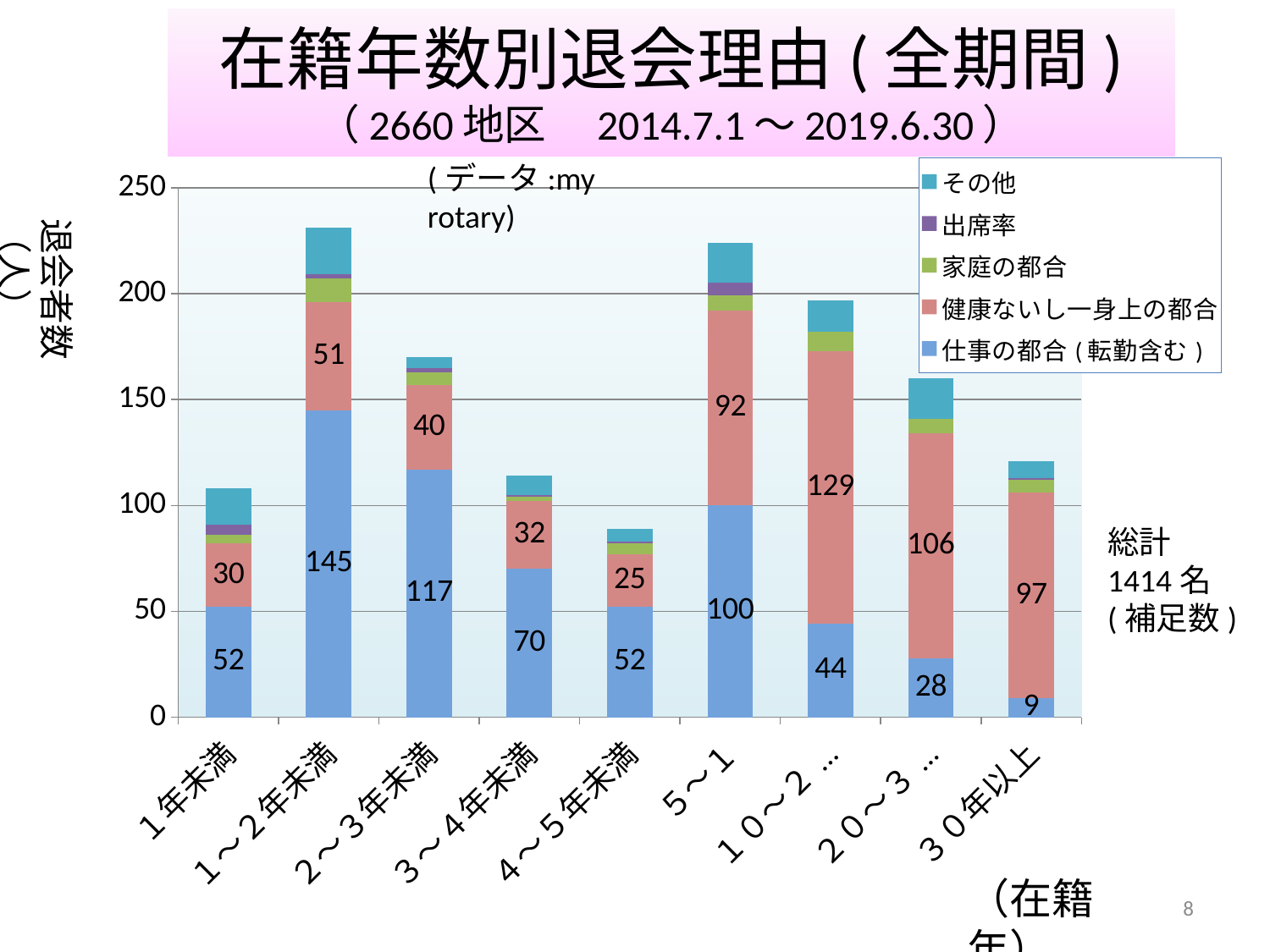
Is the total height of the ４～５年未満 bar greater or less than 100? less How many series does the legend list? 5 What is the difference between the 仕事の都合(転勤含む) values for １～２年未満 and ２～３年未満? 28 What is the value of 健康ないし一身上の都合 for ４～５年未満? 25 What is the value of 仕事の都合(転勤含む) for １～２年未満? 145 How many categories (bars) are plotted along the x axis? 9 Which category has the highest value for 仕事の都合(転勤含む)? １～２年未満 Which category has the lowest value for 仕事の都合(転勤含む)? ３０年以上 Which is larger: the 仕事の都合(転勤含む) value for ２～３年未満 or for ３～４年未満? ２～３年未満 What kind of chart is shown on the slide? Stacked bar chart What is the value of 仕事の都合(転勤含む) for ３０年以上? 9 Is the total height of the １～２年未満 bar greater or less than 200? greater